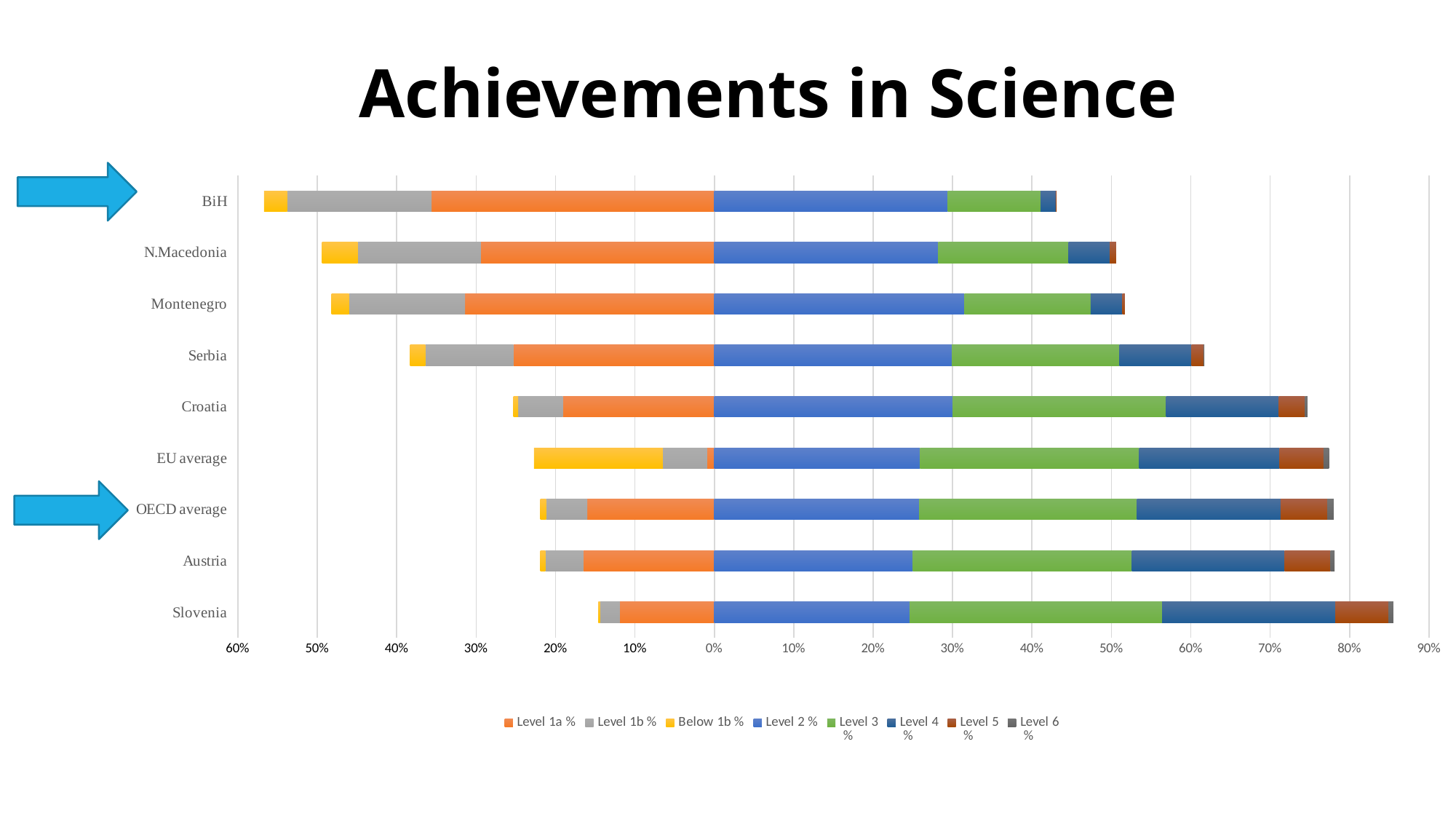
What is the title of the slide containing the chart? Achievements in Science Which category's bar extends furthest to the right (the Level 2 and above side) of the 0% line? Slovenia Which category's bar extends the least to the right of the 0% line? BiH What kind of chart is shown on the slide? bar chart How many series does the chart's legend list? 8 Which category's bar extends furthest to the left (the below Level 2 side) of the 0% line? BiH Which colour represents Level 3 % in the chart's legend? green Does the right-hand portion of the Slovenia bar extend to a value greater or less than 80%? greater Does the right-hand portion of the BiH bar extend to a value greater or less than 40%? greater Does the left-hand portion of the Croatia bar extend to a value greater or less than 30%? less How many countries or averages are listed on the vertical axis of the chart? 9 Which extends further to the left of the 0% line: the bar for BiH or the bar for Slovenia? BiH